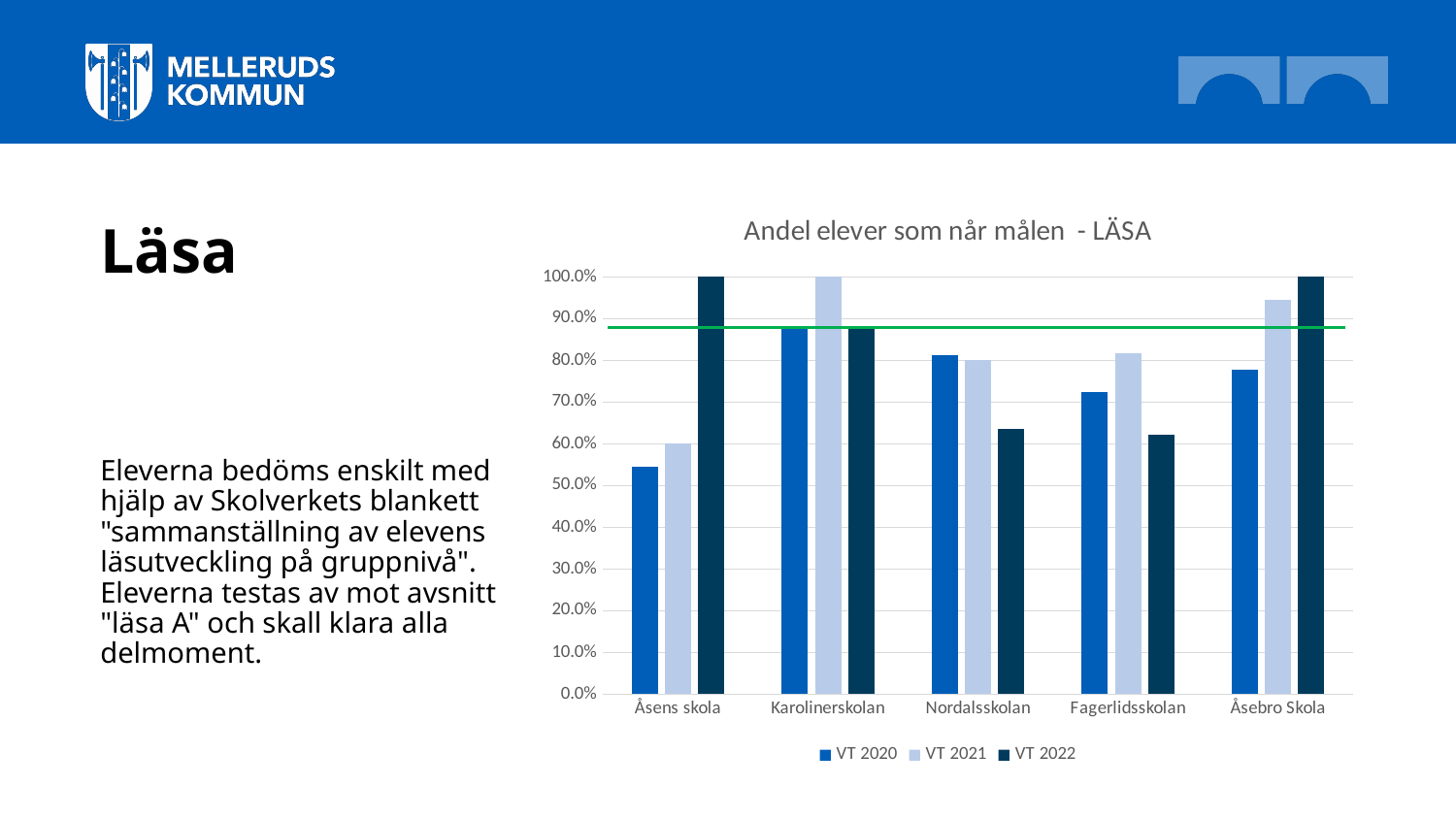
How many schools are shown on the x axis of the chart? 5 What is the title of the chart? Andel elever som når målen - LÄSA What is the VT 2022 value for Åsens skola? 100.0% What type of chart is shown on the slide? Bar chart How many series does the chart legend list? 3 Which school has the lowest VT 2020 value? Åsens skola Is the VT 2021 value for Åsebro Skola greater or less than 90.0%? greater What is the VT 2022 value for Åsebro Skola? 100.0% Which school has the highest VT 2020 value? Karolinerskolan Is the VT 2020 value for Åsens skola greater or less than 60.0%? less For Nordalsskolan, which is larger: the VT 2020 value or the VT 2022 value? VT 2020 What is the VT 2021 value for Karolinerskolan? 100.0%